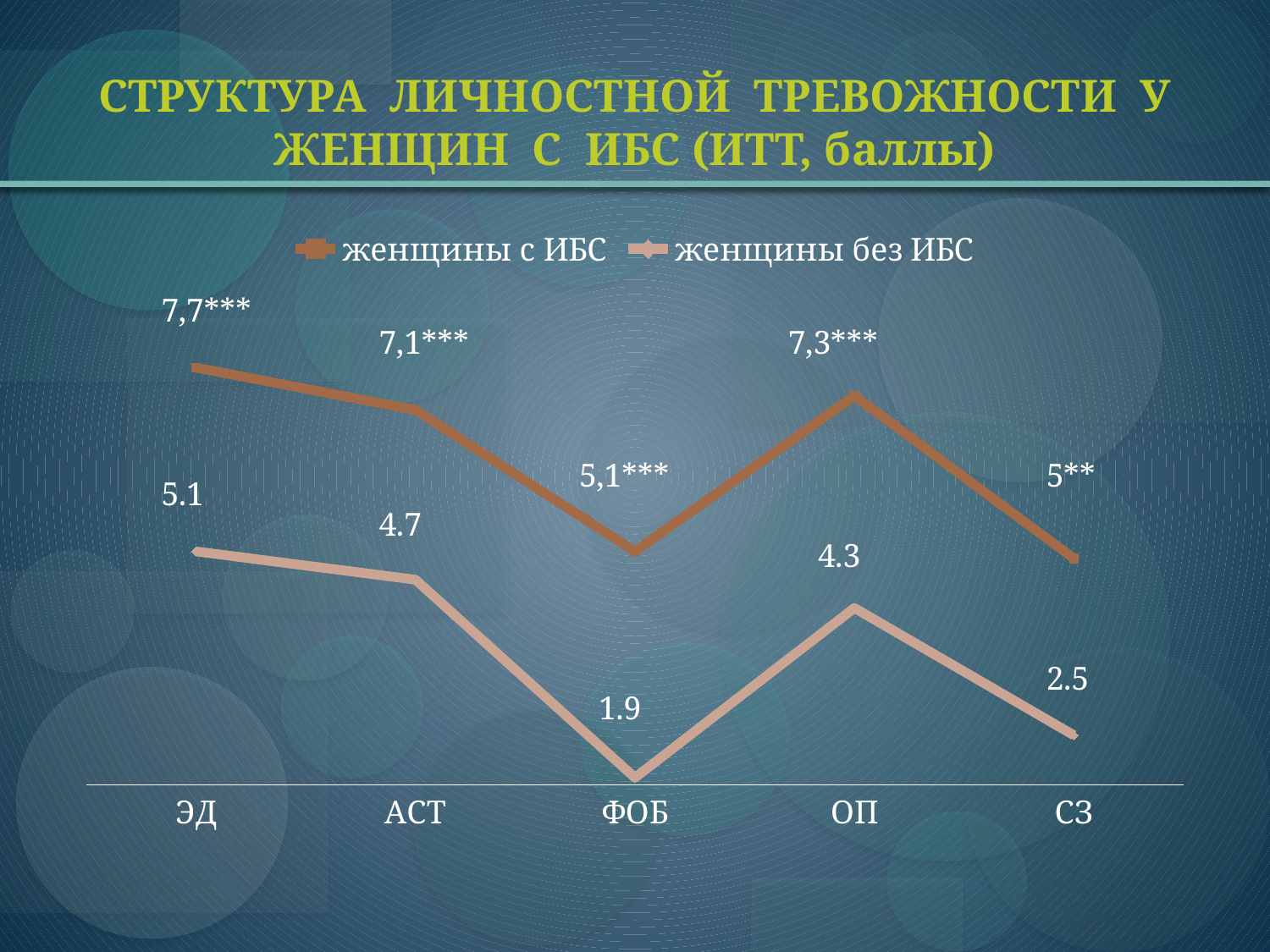
How many categories are shown on the x axis? 5 What are the two series named in the legend? женщины с ИБС and женщины без ИБС What is the value for СЗ in the series 'женщины без ИБС'? 2.5 What type of chart is shown on the slide? line chart Which category has the highest value in the series 'женщины с ИБС'? ЭД What is the value for ОП in the series 'женщины с ИБС'? 7,3*** How many series does the legend list? 2 What is the difference between the values for ЭД and ФОБ in the series 'женщины без ИБС'? 3.2 What is the value for ЭД in the series 'женщины с ИБС'? 7,7*** Which category has the lowest value in the series 'женщины без ИБС'? ФОБ What is the value for ФОБ in the series 'женщины без ИБС'? 1.9 Which series has the larger value for АСТ, 'женщины с ИБС' or 'женщины без ИБС'? женщины с ИБС